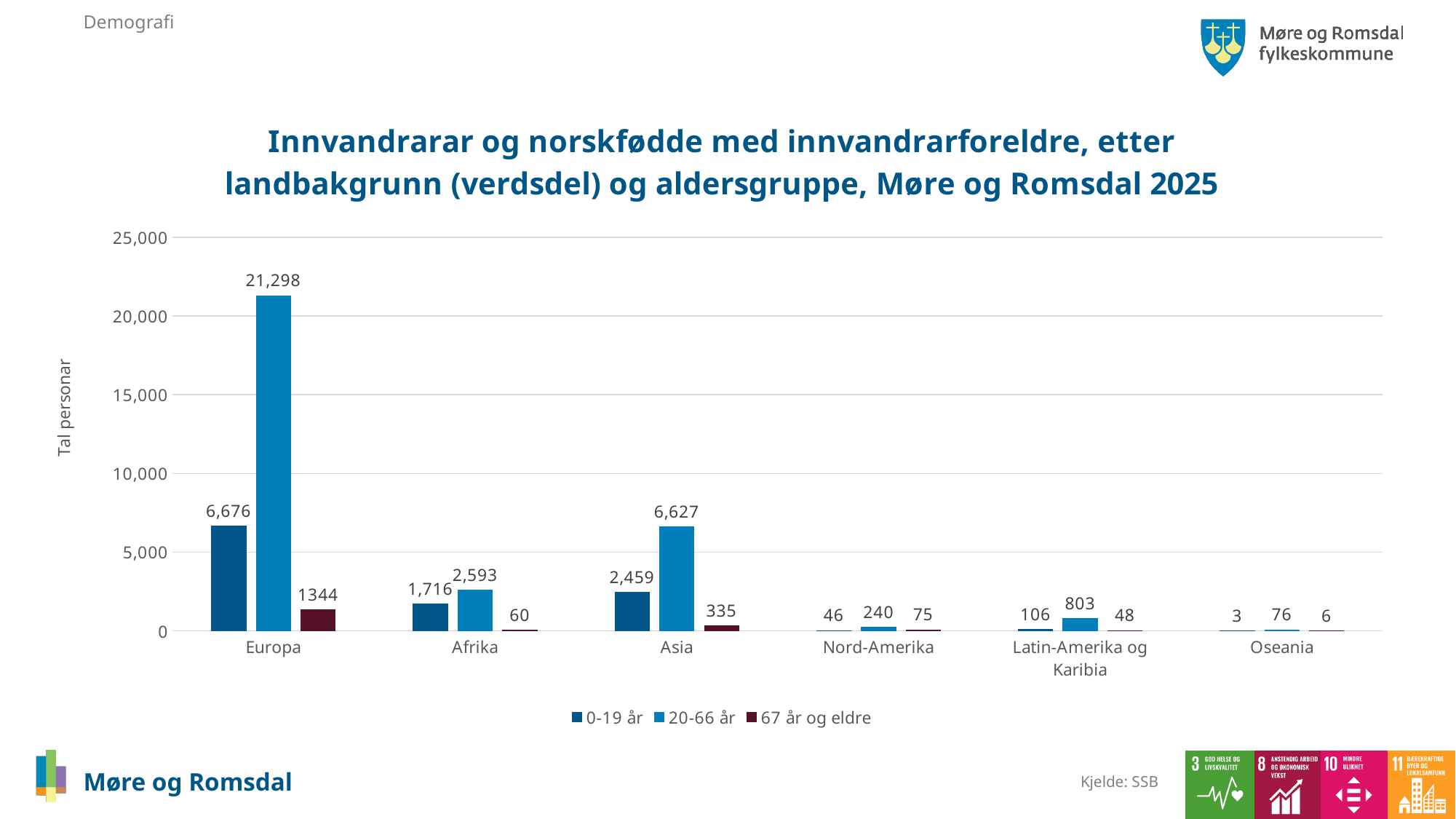
How many categories (world regions) are shown on the x axis? 6 Which category has the highest value in the 20-66 år series? Europa What is the difference between the 20-66 år and 0-19 år values for Asia? 4,168 What is the value for Latin-Amerika og Karibia in the 67 år og eldre series? 48 What kind of chart is shown on the slide? Bar chart Which category has the lowest value in the 0-19 år series? Oseania What is the value for Oseania in the 20-66 år series? 76 How many series does the legend list? 3 Which is larger for Afrika: the 0-19 år value or the 20-66 år value? 20-66 år What is the value for Asia in the 0-19 år series? 2,459 Is the value for Europa in the 20-66 år series greater or less than 20,000? greater What is the value for Europa in the 20-66 år series? 21,298